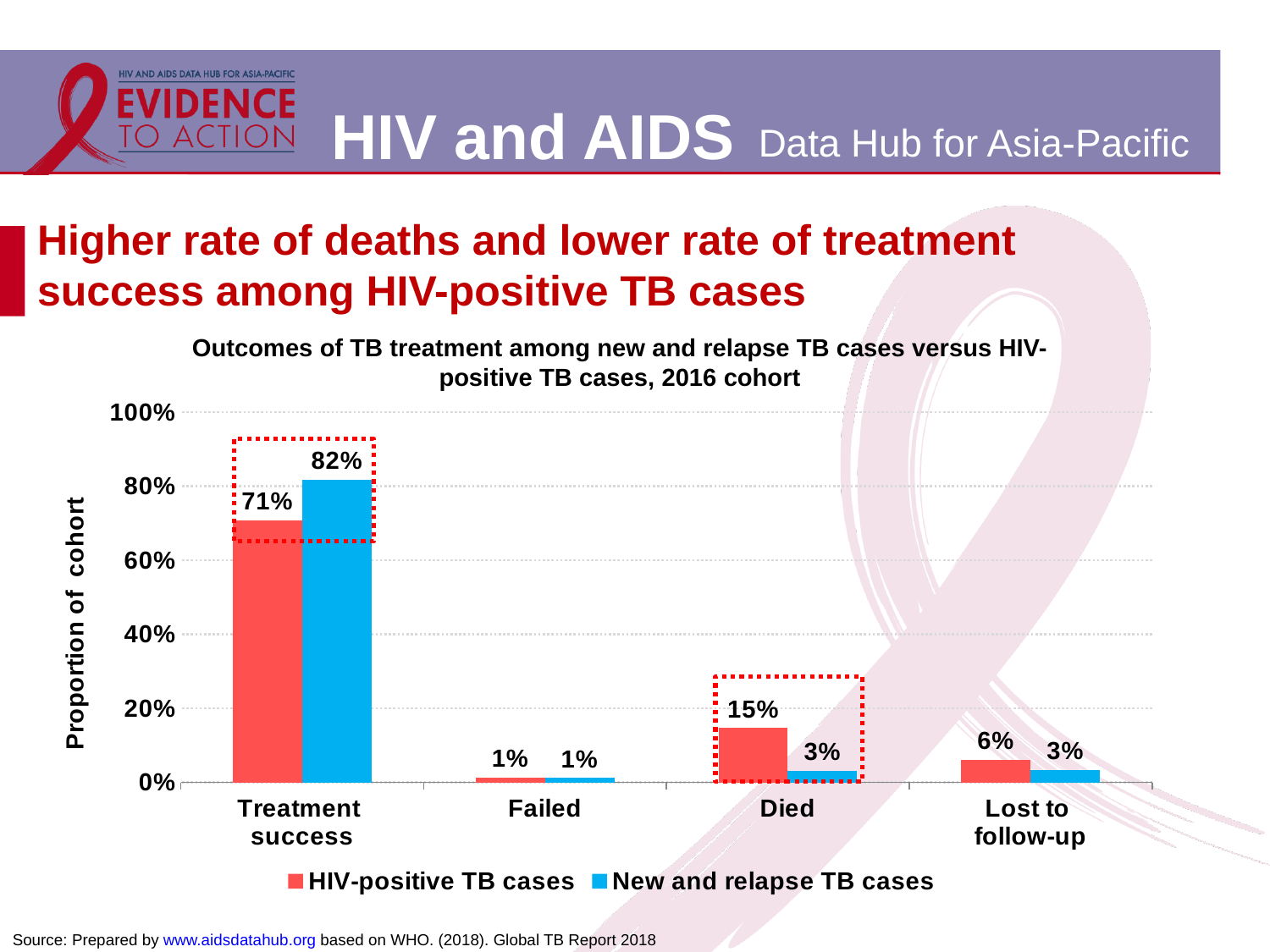
Which group has a higher proportion lost to follow-up, HIV-positive TB cases or new and relapse TB cases? HIV-positive TB cases What is the treatment success rate for HIV-positive TB cases? 71% What is the difference in the proportion who died between HIV-positive TB cases and new and relapse TB cases? 12% What is the difference in treatment success between new and relapse TB cases and HIV-positive TB cases? 11% What kind of chart is shown on the slide? Bar chart What proportion of HIV-positive TB cases died? 15% What is the treatment success rate for new and relapse TB cases? 82% Which outcome category has the highest value for HIV-positive TB cases? Treatment success How many series does the legend list? 2 Which outcome category has the lowest value for new and relapse TB cases? Failed How many outcome categories are shown on the x axis? 4 What proportion of new and relapse TB cases were lost to follow-up? 3%